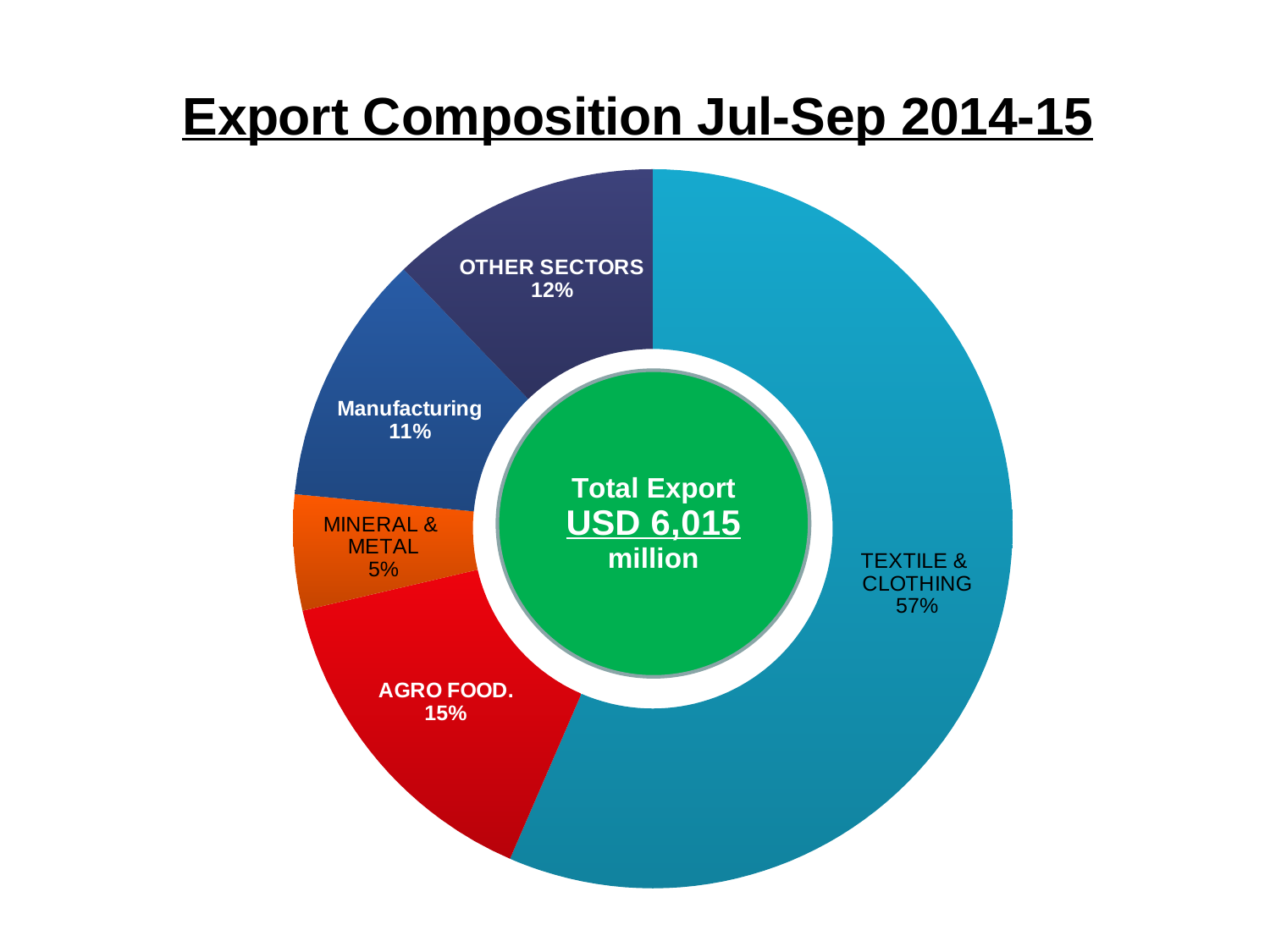
Which has a larger share, Manufacturing or OTHER SECTORS? OTHER SECTORS What share of exports does AGRO FOOD account for? 15% What kind of chart is shown on the slide? Pie chart (doughnut) What share of exports does MINERAL & METAL account for? 5% What total export value is shown in the centre of the chart? USD 6,015 million What share of exports does OTHER SECTORS account for? 12% What share of exports does TEXTILE & CLOTHING account for? 57% Which sector has the largest share of exports? TEXTILE & CLOTHING How many sectors are shown in the chart? 5 What share of exports does Manufacturing account for? 11% Which sector has the smallest share of exports? MINERAL & METAL What is the difference in percentage points between the TEXTILE & CLOTHING share and the AGRO FOOD share? 42